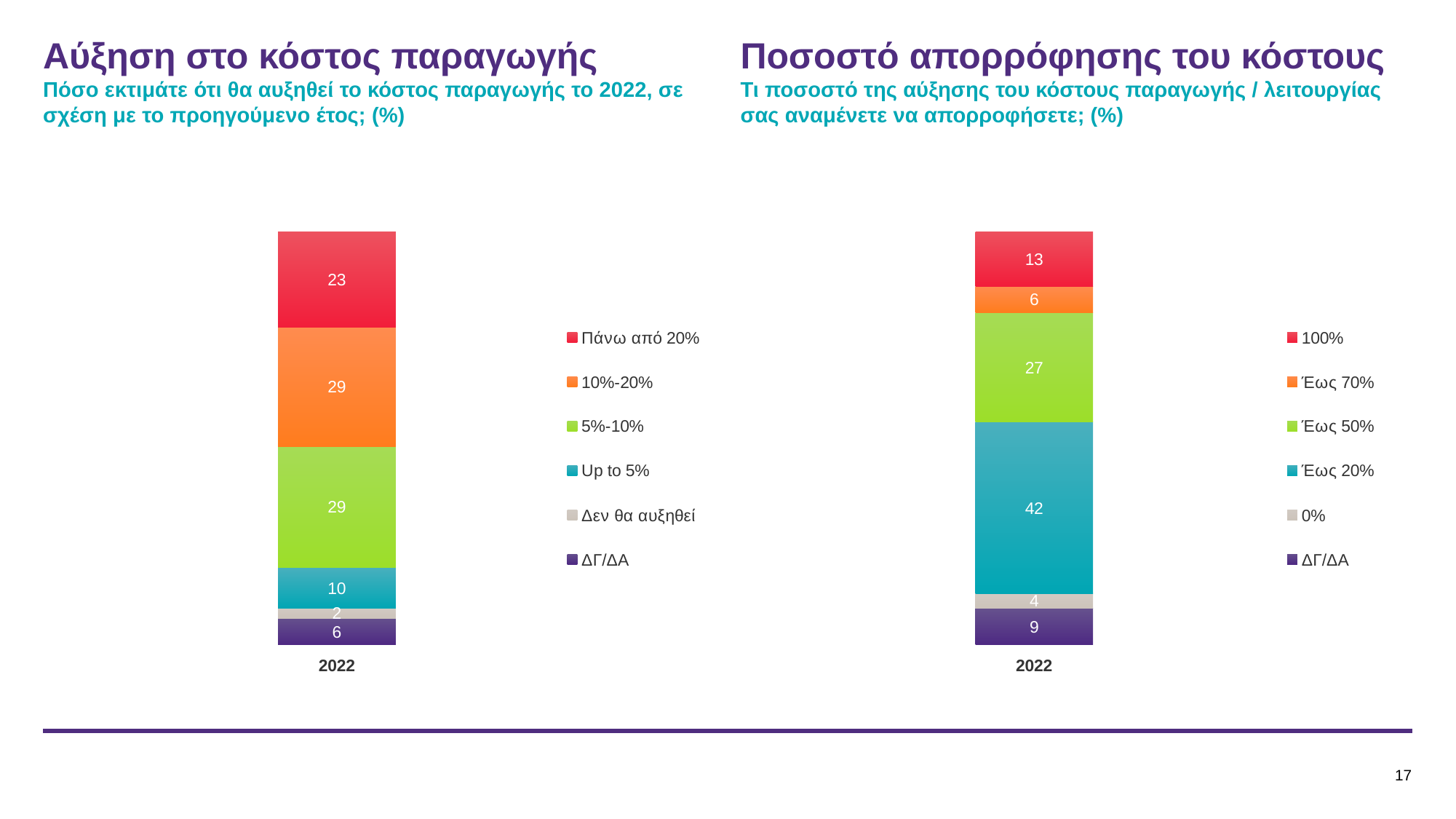
In the left chart (Αύξηση στο κόστος παραγωγής), what is the value for the 'Up to 5%' segment? 10 In the left chart (Αύξηση στο κόστος παραγωγής), what is the value for the 'Πάνω από 20%' segment? 23 In the left chart (Αύξηση στο κόστος παραγωγής), what is the difference between the 'Πάνω από 20%' segment and the 'ΔΓ/ΔΑ' segment? 17 In the left chart (Αύξηση στο κόστος παραγωγής), which segment has the smallest value? Δεν θα αυξηθεί In the right chart (Ποσοστό απορρόφησης του κόστους), what is the value for the '100%' segment? 13 In the right chart (Ποσοστό απορρόφησης του κόστους), what is the value for the 'Έως 20%' segment? 42 In the right chart (Ποσοστό απορρόφησης του κόστους), which is larger: the 'Έως 50%' segment or the '100%' segment? Έως 50% What kind of chart is shown on the right side of the slide (Ποσοστό απορρόφησης του κόστους)? Stacked bar chart In the left chart (Αύξηση στο κόστος παραγωγής), how many series does the legend list? 6 In the right chart (Ποσοστό απορρόφησης του κόστους), what is the total of the stacked bar for 2022? 101 In the right chart (Ποσοστό απορρόφησης του κόστους), which segment has the largest value? Έως 20% In the right chart (Ποσοστό απορρόφησης του κόστους), what is the difference between the 'Έως 20%' segment and the 'Έως 50%' segment? 15